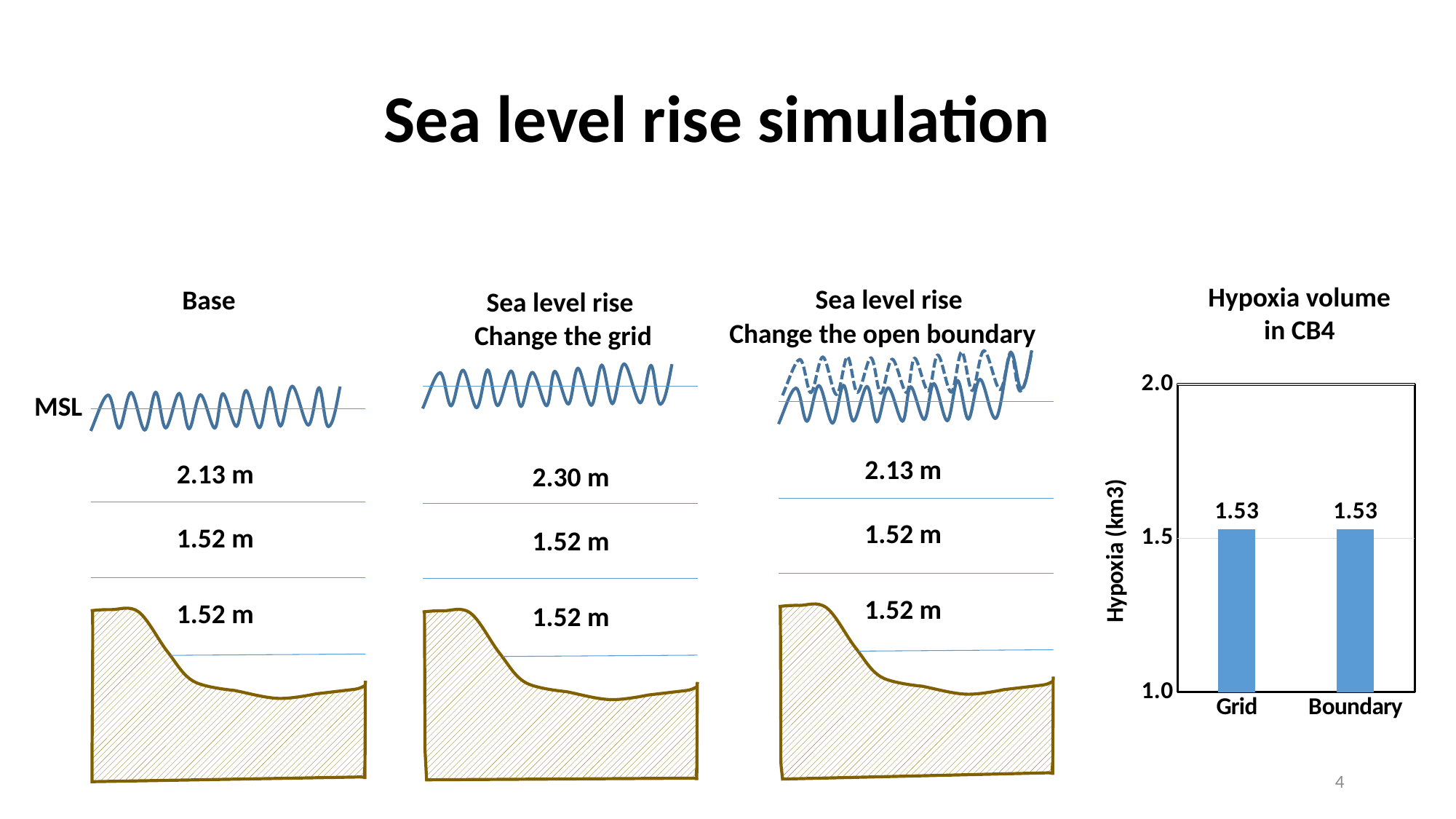
What is the title of the bar chart on the right of the slide? Hypoxia volume in CB4 How many categories are shown in the Hypoxia volume in CB4 chart? 2 What is the hypoxia volume for Grid in the Hypoxia volume in CB4 chart? 1.53 What kind of chart is the Hypoxia volume in CB4 chart? bar chart What is the y-axis label of the Hypoxia volume in CB4 chart? Hypoxia (km3) In the Hypoxia volume in CB4 chart, is the value for Grid greater or less than 2.0? less What is the hypoxia volume for Boundary in the Hypoxia volume in CB4 chart? 1.53 In the Hypoxia volume in CB4 chart, is the value for Boundary greater or less than 1.0? greater In the Hypoxia volume in CB4 chart, do the values rise, fall, or stay the same from Grid to Boundary? stay the same In the Hypoxia volume in CB4 chart, what is the difference between the Grid and Boundary values? 0